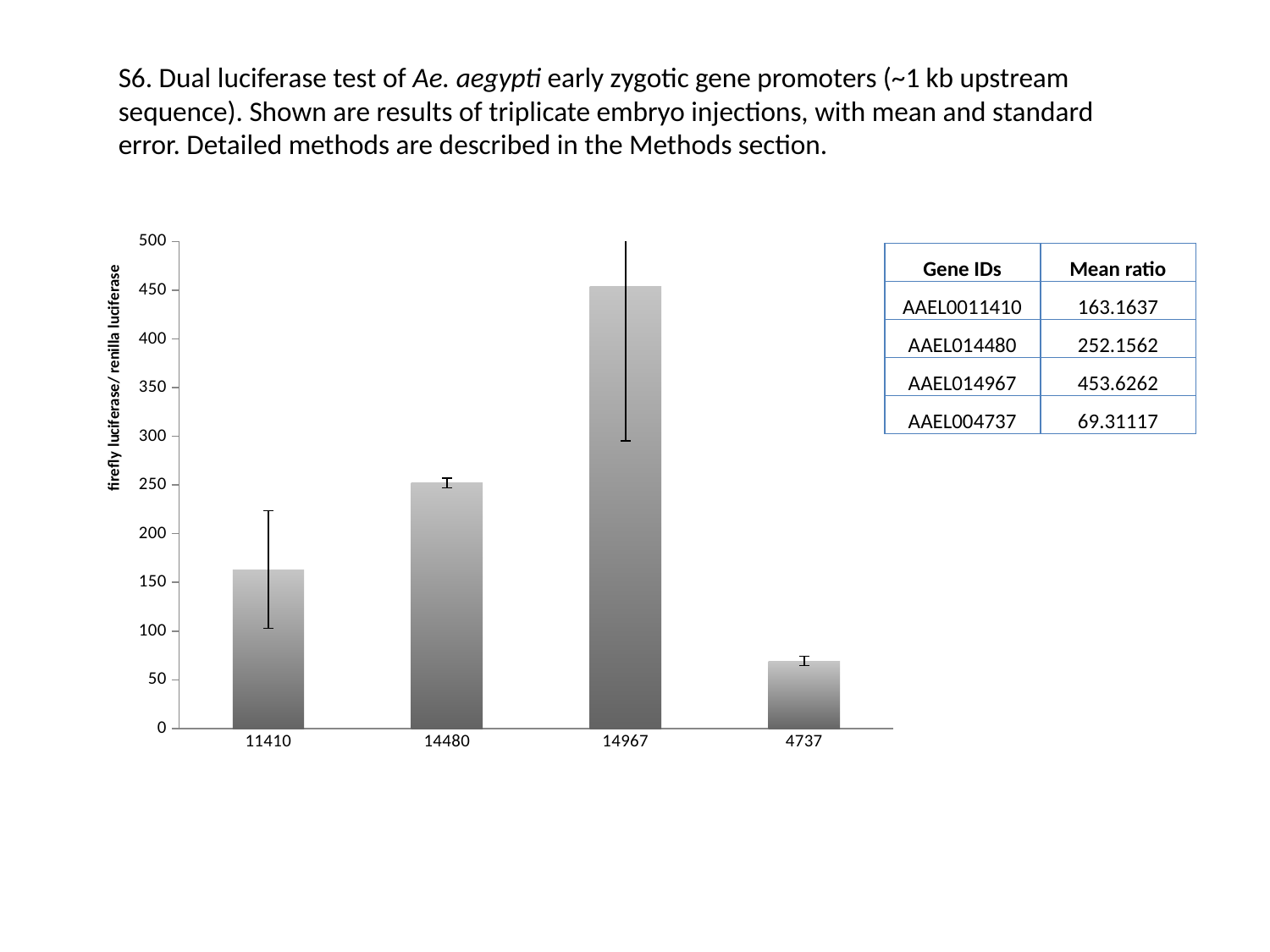
Is the value for 11410 greater or less than 150? greater What is the label of the vertical axis of the chart? firefly luciferase/ renilla luciferase How many bars (categories) are plotted in the chart? 4 What kind of chart is shown on the slide? bar chart According to the table on the slide, what is the mean ratio for AAEL014480? 252.1562 What is the difference between the mean ratios of AAEL014480 and AAEL0011410 as given in the table? 88.9925 Is the value for 4737 greater or less than 100? less Which bar is taller, 14480 or 11410? 14480 Which category has the highest bar in the chart? 14967 Which category has the lowest bar in the chart? 4737 According to the table on the slide, what is the mean ratio for AAEL004737? 69.31117 According to the table on the slide, what is the mean ratio for AAEL014967? 453.6262